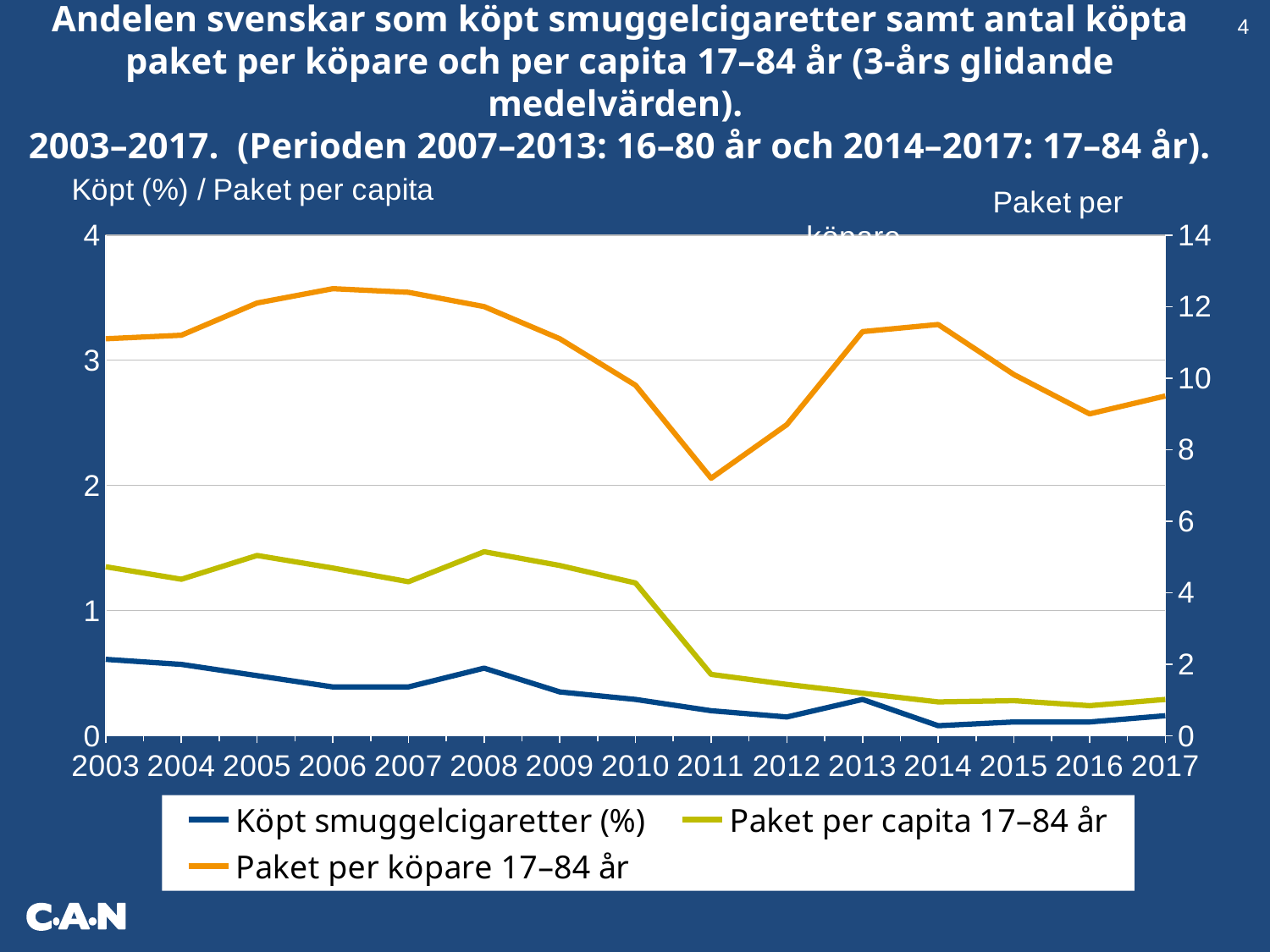
What kind of chart is shown on the slide? line chart In which year does the 'Paket per köpare 17–84 år' line reach its highest value? 2006 What colour is the 'Paket per köpare 17–84 år' line? orange Is the value for 'Paket per köpare 17–84 år' in 2011 greater or less than 8 on the right axis? less Which is larger for 'Paket per capita 17–84 år': the value in 2010 or the value in 2011? 2010 Does the 'Köpt smuggelcigaretter (%)' line generally rise or fall from 2003 to 2017? fall How many years are plotted along the x axis? 15 How many series does the legend list? 3 Is the value for 'Paket per köpare 17–84 år' in 2013 greater or less than 10 on the right axis? greater In which year does the 'Paket per köpare 17–84 år' line reach its lowest value? 2011 Is the value for 'Paket per capita 17–84 år' in 2008 greater or less than 1 on the left axis? greater